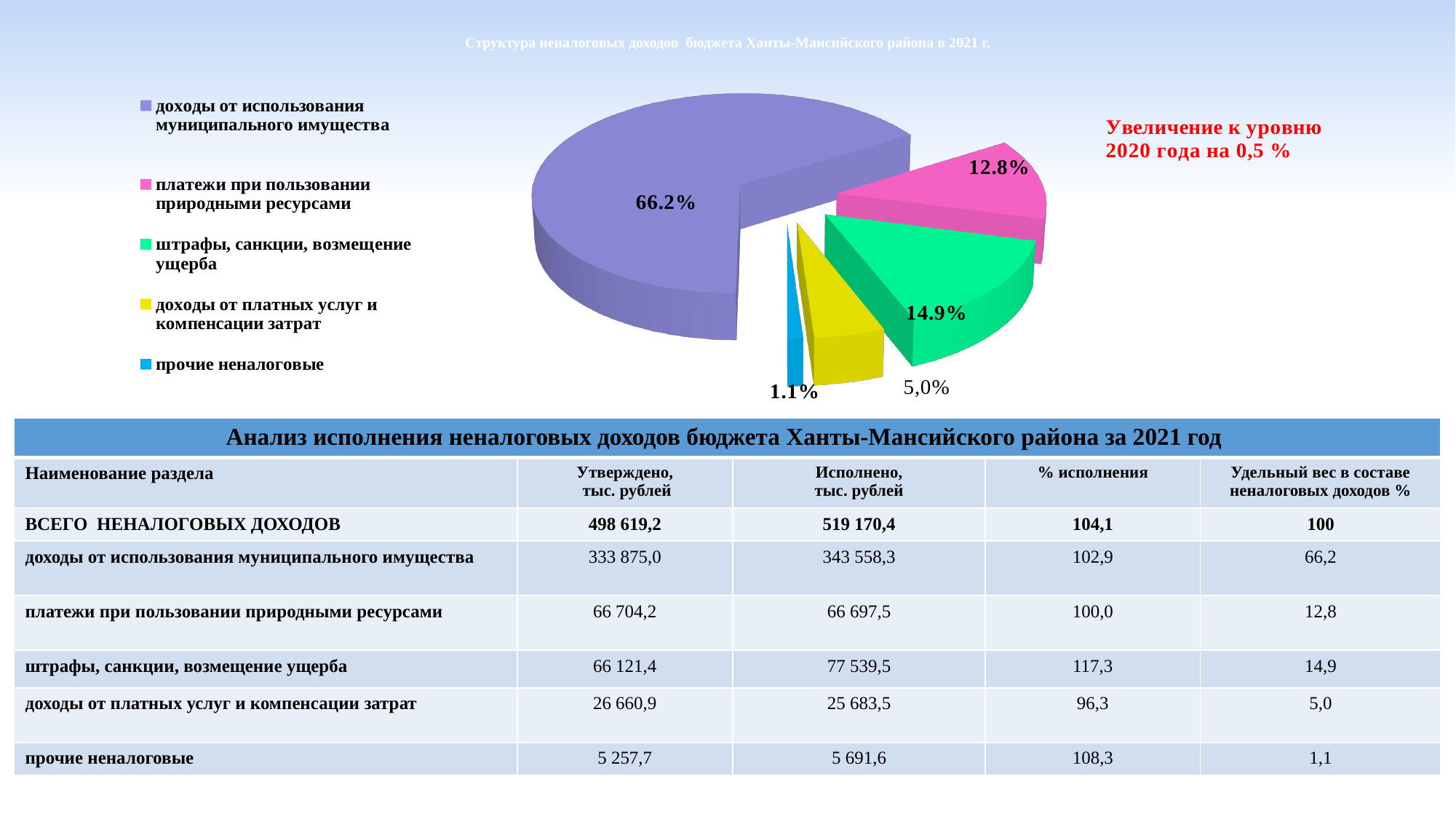
Which category has the largest slice in the pie chart? доходы от использования муниципального имущества What is the difference in percentage points between the "штрафы, санкции, возмещение ущерба" slice and the "платежи при пользовании природными ресурсами" slice? 2.1 Which category has the smallest slice in the pie chart? прочие неналоговые What share of the pie chart does "платежи при пользовании природными ресурсами" have? 12.8% How many slices does the pie chart have? 5 What type of chart is shown on the slide? pie chart What share of the pie chart does "доходы от платных услуг и компенсации затрат" have? 5,0% Which slice is larger in the pie chart: "штрафы, санкции, возмещение ущерба" or "платежи при пользовании природными ресурсами"? штрафы, санкции, возмещение ущерба What share of the pie chart does "доходы от использования муниципального имущества" have? 66.2% What share of the pie chart does "штрафы, санкции, возмещение ущерба" have? 14.9% What colour is the slice for "прочие неналоговые" in the pie chart? blue What share of the pie chart does "прочие неналоговые" have? 1.1%